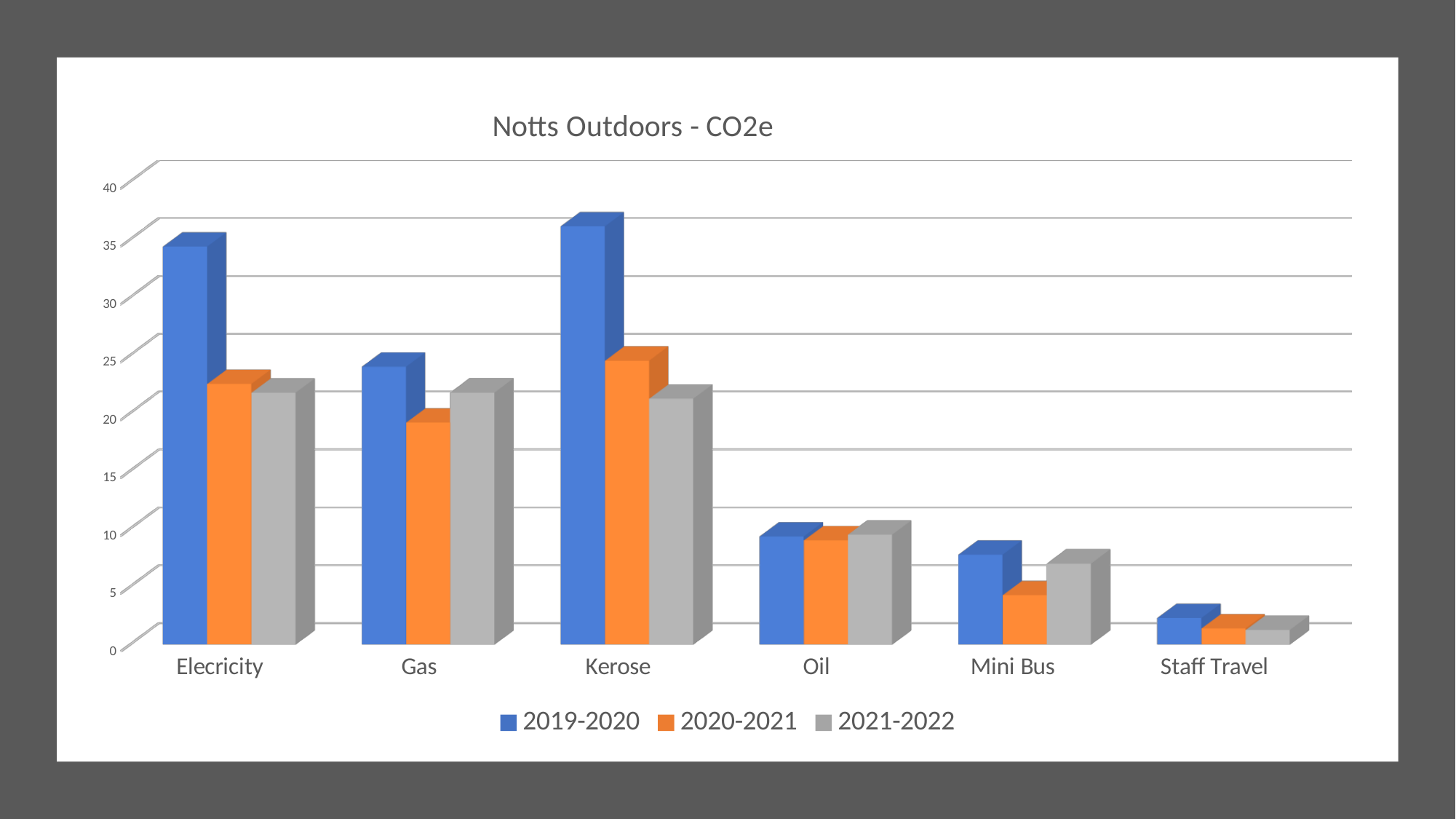
Do the values for Elecricity rise or fall from 2019-2020 to 2021-2022? fall How many series does the legend list? 3 Is the 2019-2020 value for Elecricity greater or less than 30? greater What kind of chart is shown on the slide? Bar chart How many categories are shown on the x axis? 6 Which category has the lowest values across all three series? Staff Travel Which is larger, the 2019-2020 value for Elecricity or the 2019-2020 value for Gas? Elecricity What is the title of the chart? Notts Outdoors - CO2e Which category has the highest 2019-2020 value? Kerose